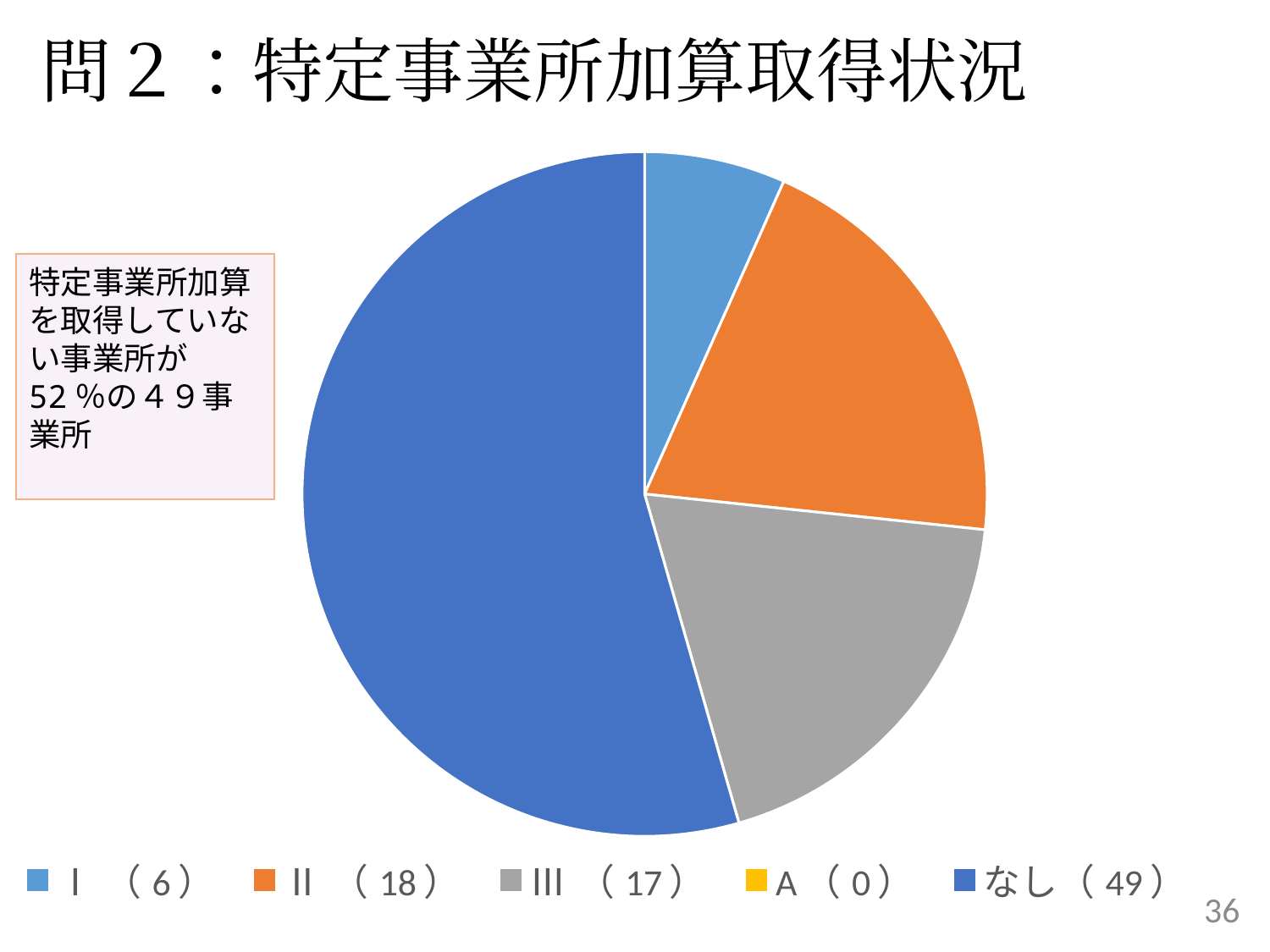
What type of chart is shown on the slide? pie chart What is the value for I in the pie chart? 6 Which is larger, the value for II or the value for III? II What is the value for II in the pie chart? 18 What is the value for A in the pie chart? 0 How many categories does the legend of the pie chart list? 5 What is the value for なし in the pie chart? 49 What is the difference between the values for なし and II? 31 What colour is the slice for なし in the pie chart? blue Which category has the largest value in the pie chart? なし What is the value for III in the pie chart? 17 Which category has the smallest value in the pie chart? A